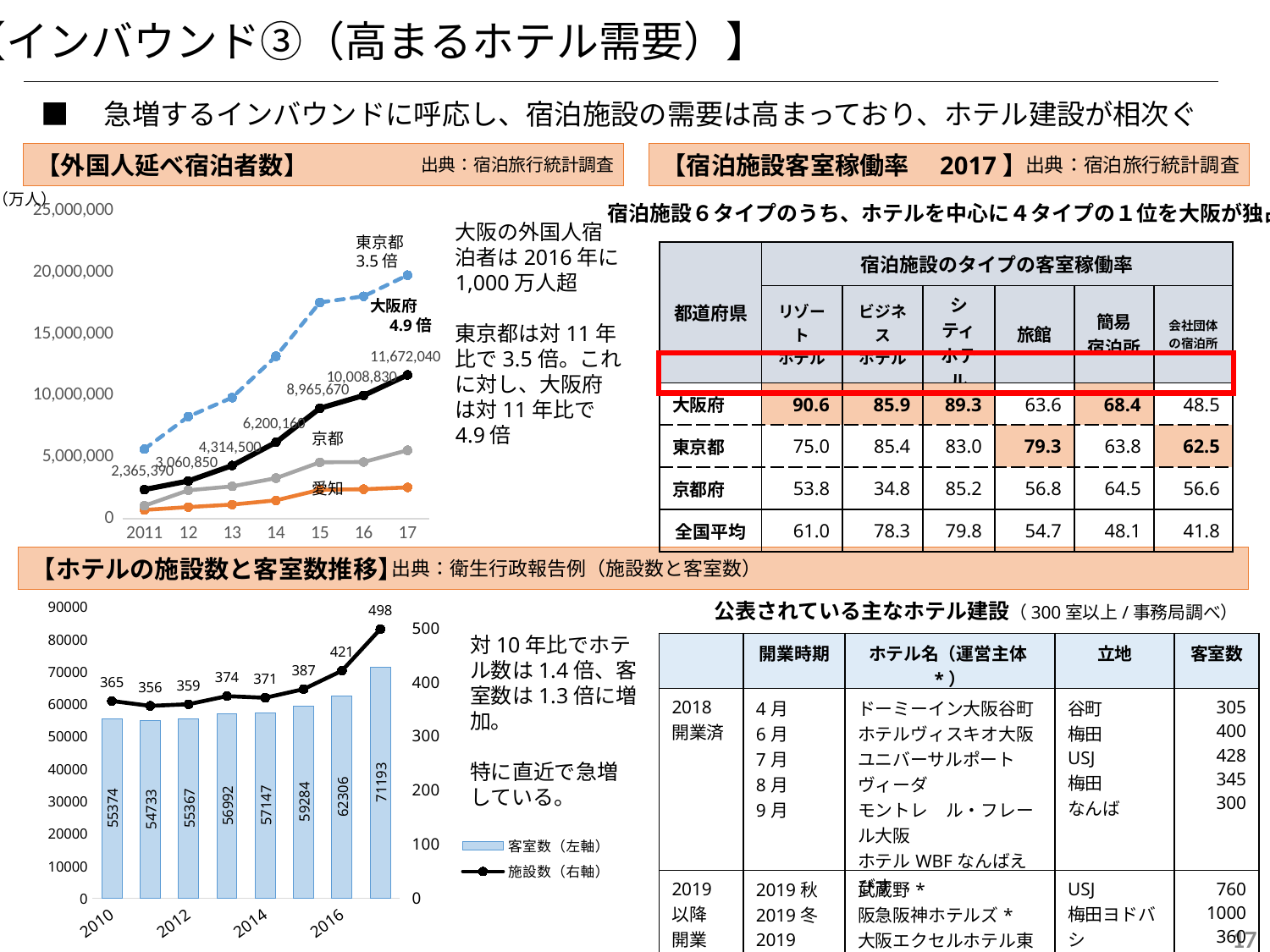
What kind of chart is the 【外国人延べ宿泊者数】 chart? line chart In the 【ホテルの施設数と客室数推移】 chart, what is the 客室数 value for 2017? 71193 How many years are shown on the x axis of the 【外国人延べ宿泊者数】 chart? 7 In the 【外国人延べ宿泊者数】 chart, what is the value for 大阪府 in 2011? 2,365,390 How many series does the legend of the 【ホテルの施設数と客室数推移】 chart list? 2 In the 【ホテルの施設数と客室数推移】 chart, what is the difference in 施設数 between 2017 and 2016? 77 In the 【外国人延べ宿泊者数】 chart, by how much did the 大阪府 value increase from 2011 to 2017? 9,306,650 In the 【外国人延べ宿泊者数】 chart, what is the value for 大阪府 in 2017? 11,672,040 In the 【外国人延べ宿泊者数】 chart, is the value for 東京都 in 2017 greater or less than 15,000,000? greater In the 【ホテルの施設数と客室数推移】 chart, what is the 施設数 value for 2017? 498 In the 【ホテルの施設数と客室数推移】 chart, which year has the lowest 施設数? 2011 In the 【外国人延べ宿泊者数】 chart, which prefecture has the highest value in 2017? 東京都